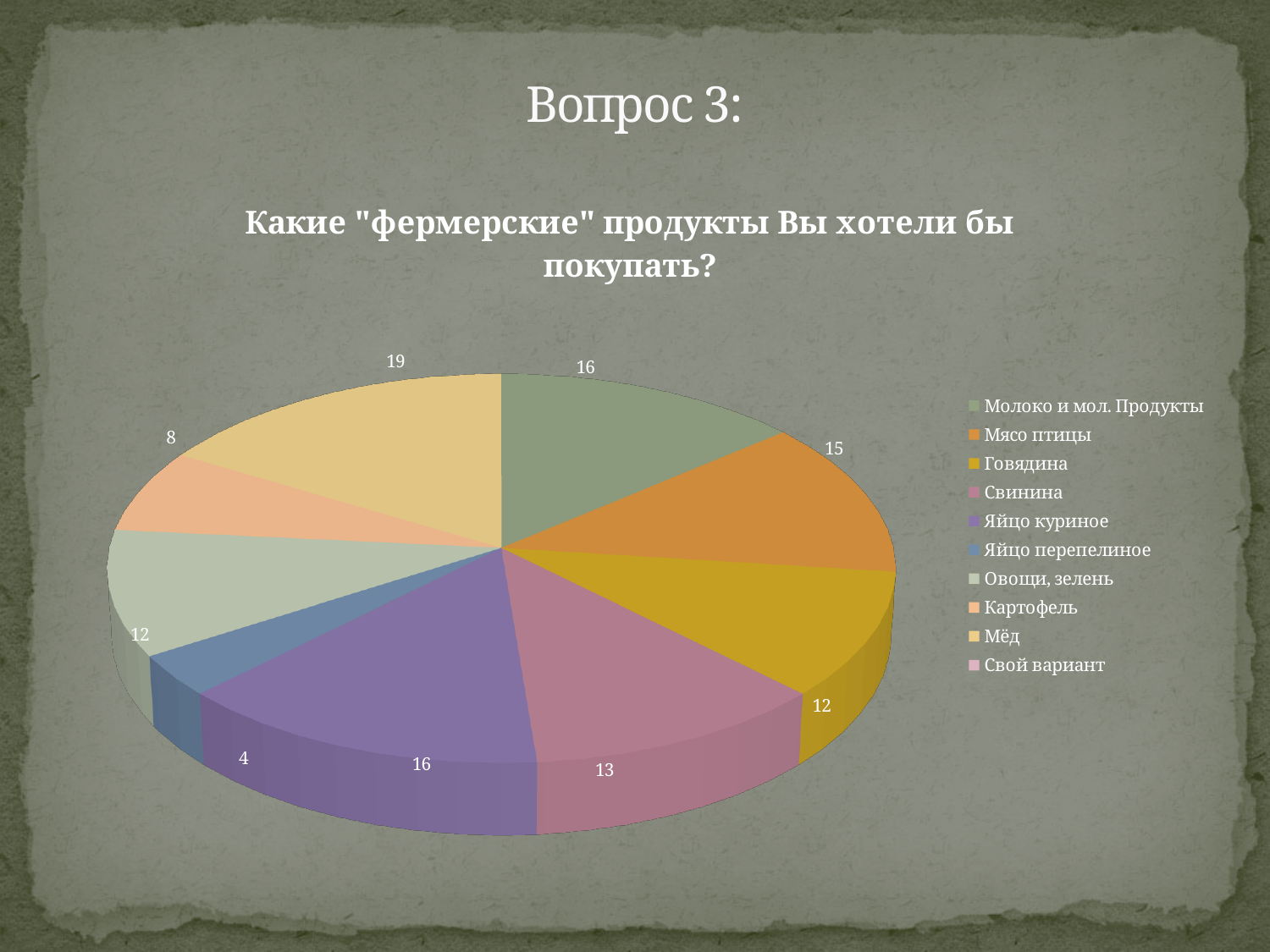
Which category has the smallest visible slice? Яйцо перепелиное What is the value for Яйцо перепелиное? 4 What is the value for Мясо птицы? 15 How many entries does the legend list? 10 Which category has the largest slice? Мёд What is the value for Мёд? 19 Which is larger, the value for Мясо птицы or the value for Говядина? Мясо птицы What is the value for Картофель? 8 What type of chart is shown on the slide? pie chart What is the title of the chart? Какие "фермерские" продукты Вы хотели бы покупать? What is the value for Свинина? 13 What is the difference between the values for Мёд and Картофель? 11